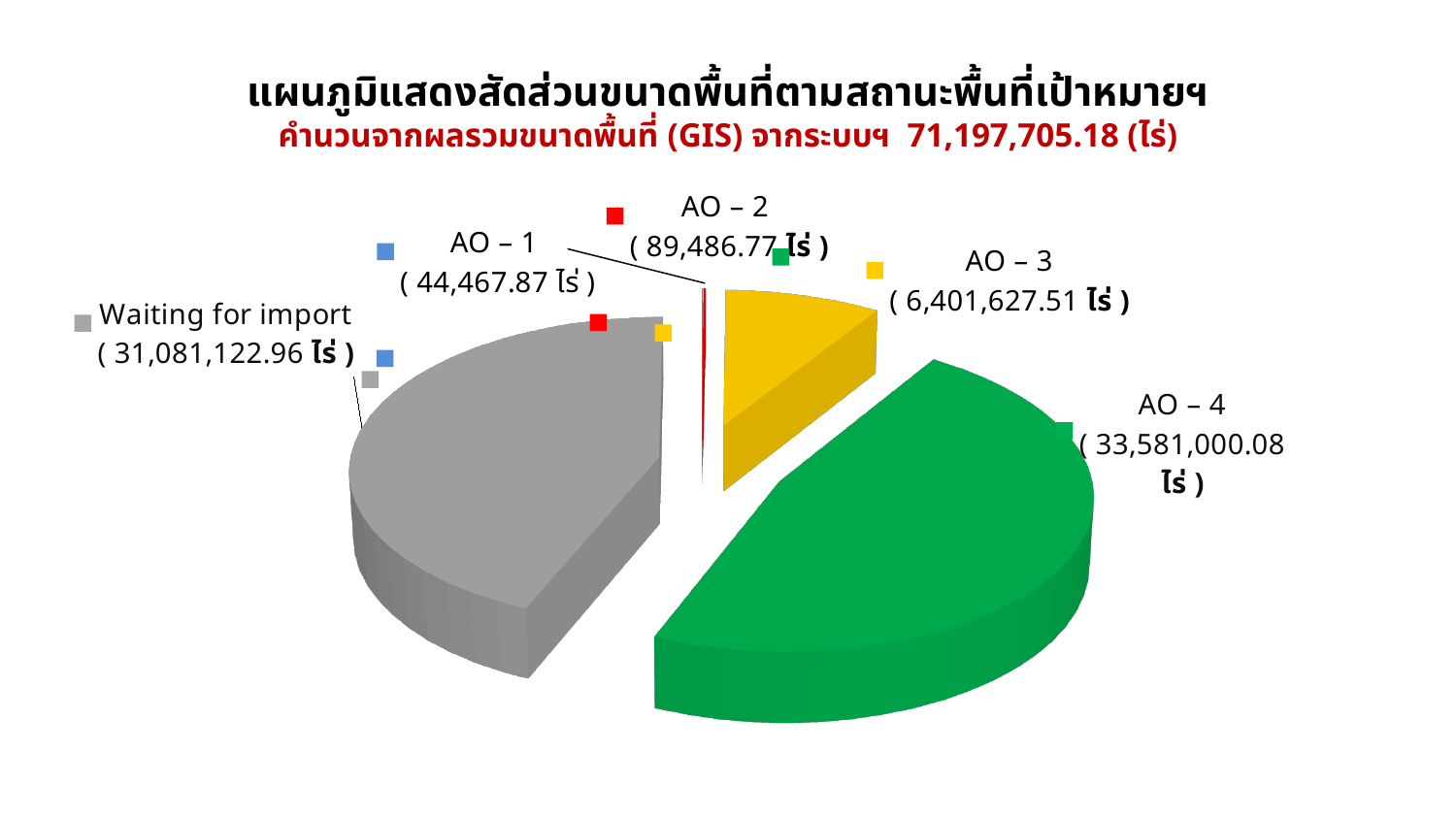
What colour is the AO – 4 slice? Green How many categories are shown in the pie chart? 5 What is the value for AO – 4? 33,581,000.08 ไร่ What is the value for Waiting for import? 31,081,122.96 ไร่ What is the value for AO – 1? 44,467.87 ไร่ What is the difference between AO – 4 and Waiting for import? 2,499,877.12 ไร่ What is the value for AO – 3? 6,401,627.51 ไร่ What kind of chart is shown on the slide? Pie chart What is the value for AO – 2? 89,486.77 ไร่ Which category has the largest area? AO – 4 Which is larger, AO – 3 or AO – 2? AO – 3 Which category has the smallest area? AO – 1